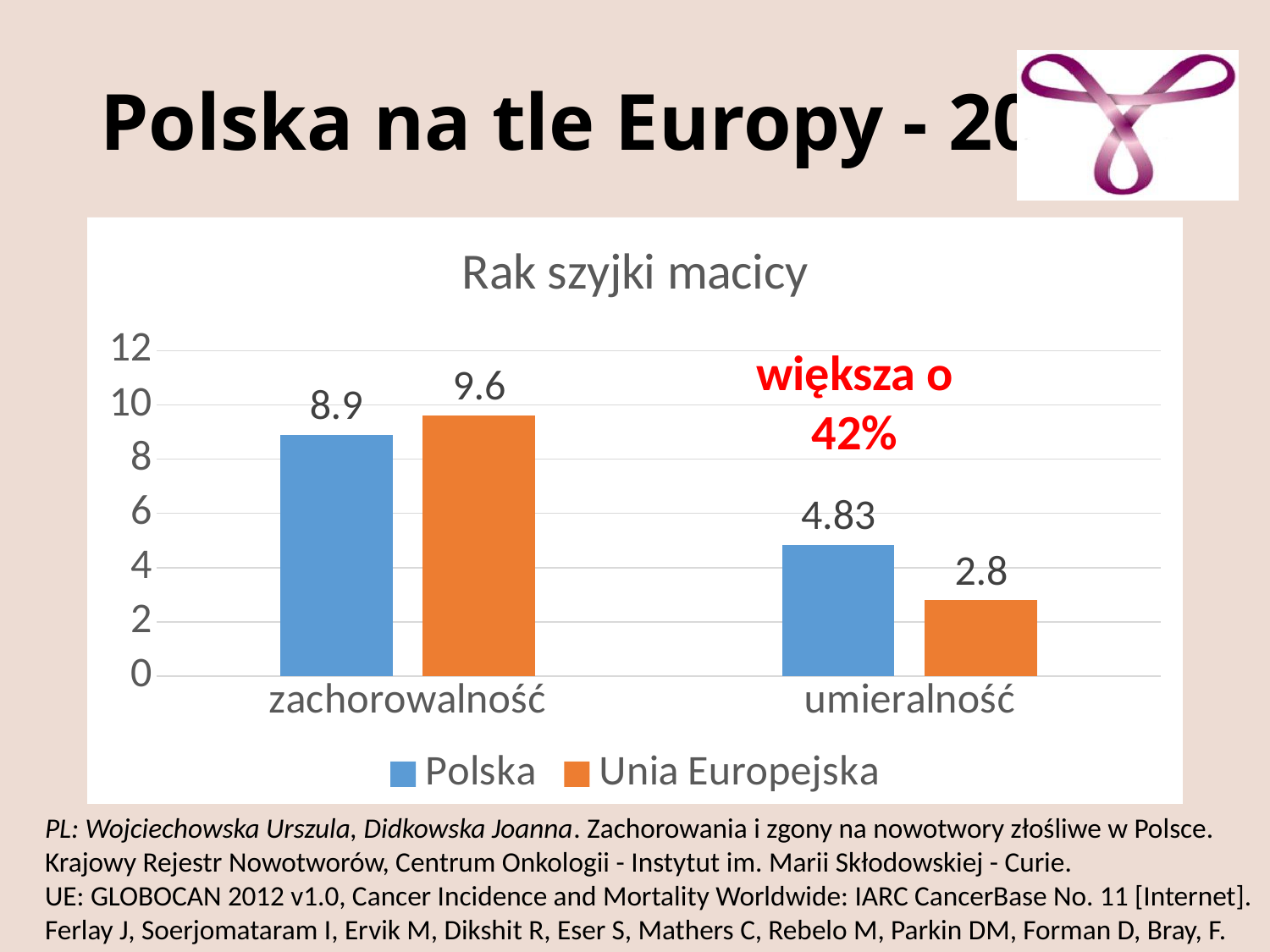
What is the difference between the Unia Europejska and Polska values in the zachorowalność category? 0.7 What type of chart is shown? Bar chart What is the value for Polska in the zachorowalność category? 8.9 What is the title of the chart? Rak szyjki macicy How many series does the legend list? 2 What is the value for Unia Europejska in the zachorowalność category? 9.6 Which series has the higher value in the umieralność category? Polska What is the value for Unia Europejska in the umieralność category? 2.8 What is the value for Polska in the umieralność category? 4.83 Which bar is the lowest in the chart? Unia Europejska, umieralność What is the difference between the Polska and Unia Europejska values in the umieralność category? 2.03 Which series has the higher value in the zachorowalność category? Unia Europejska